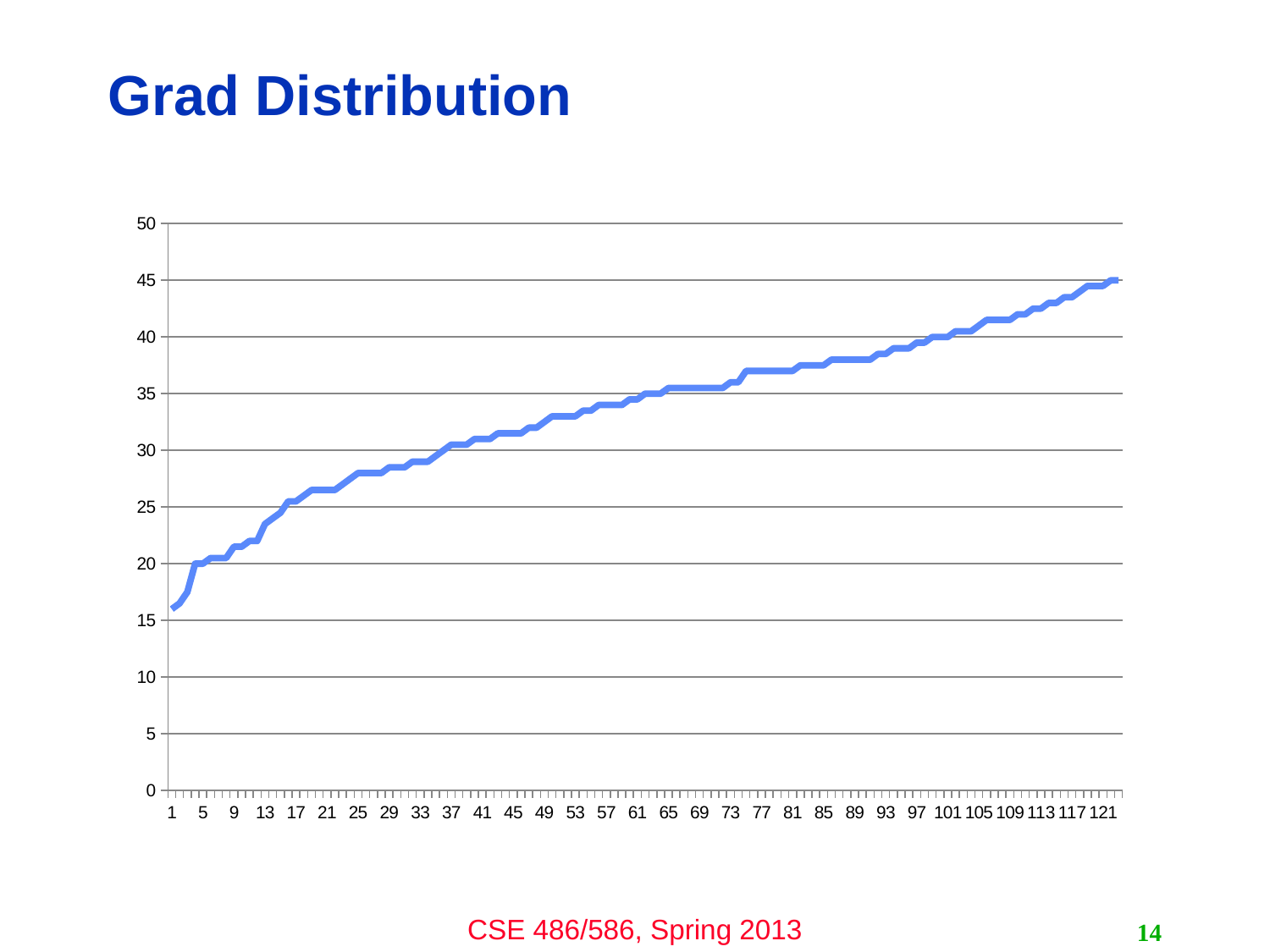
Is the value at x = 25 greater or less than 25? greater Do the values rise or fall as the x axis goes from 1 to 121? rise Is the value at x = 85 greater or less than 35? greater Is the value at x = 49 greater or less than 30? greater What is the highest value shown on the y axis? 50 What is the title of the slide containing the chart? Grad Distribution Which is larger, the value at x = 21 or the value at x = 97? x = 97 What kind of chart is shown on the slide? line chart